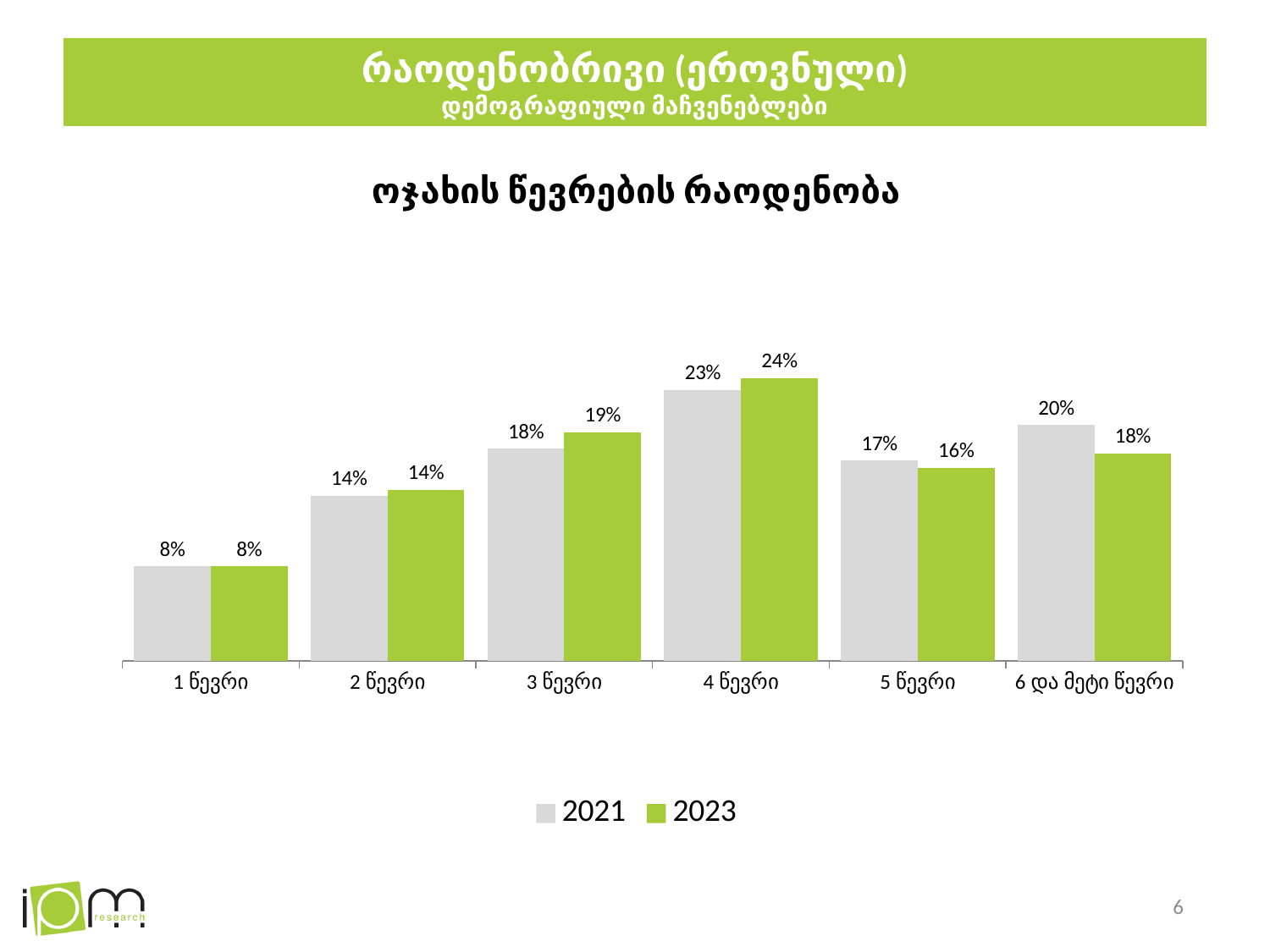
What is the value for 2021 in the "6 და მეტი წევრი" category? 20% How many series does the legend list? 2 Which category has the lowest value for the 2021 series? 1 წევრი How many categories are shown on the x axis? 6 What is the value for 2021 in the "3 წევრი" category? 18% In the "5 წევრი" category, which series has the larger value, 2021 or 2023? 2021 What is the value for 2023 in the "4 წევრი" category? 24% What is the difference between the 2021 and 2023 values in the "6 და მეტი წევრი" category? 2% In the "3 წევრი" category, which series has the larger value, 2021 or 2023? 2023 What kind of chart is shown on the slide? Bar chart Which series is shown in green in the legend? 2023 Which category has the highest value for the 2023 series? 4 წევრი